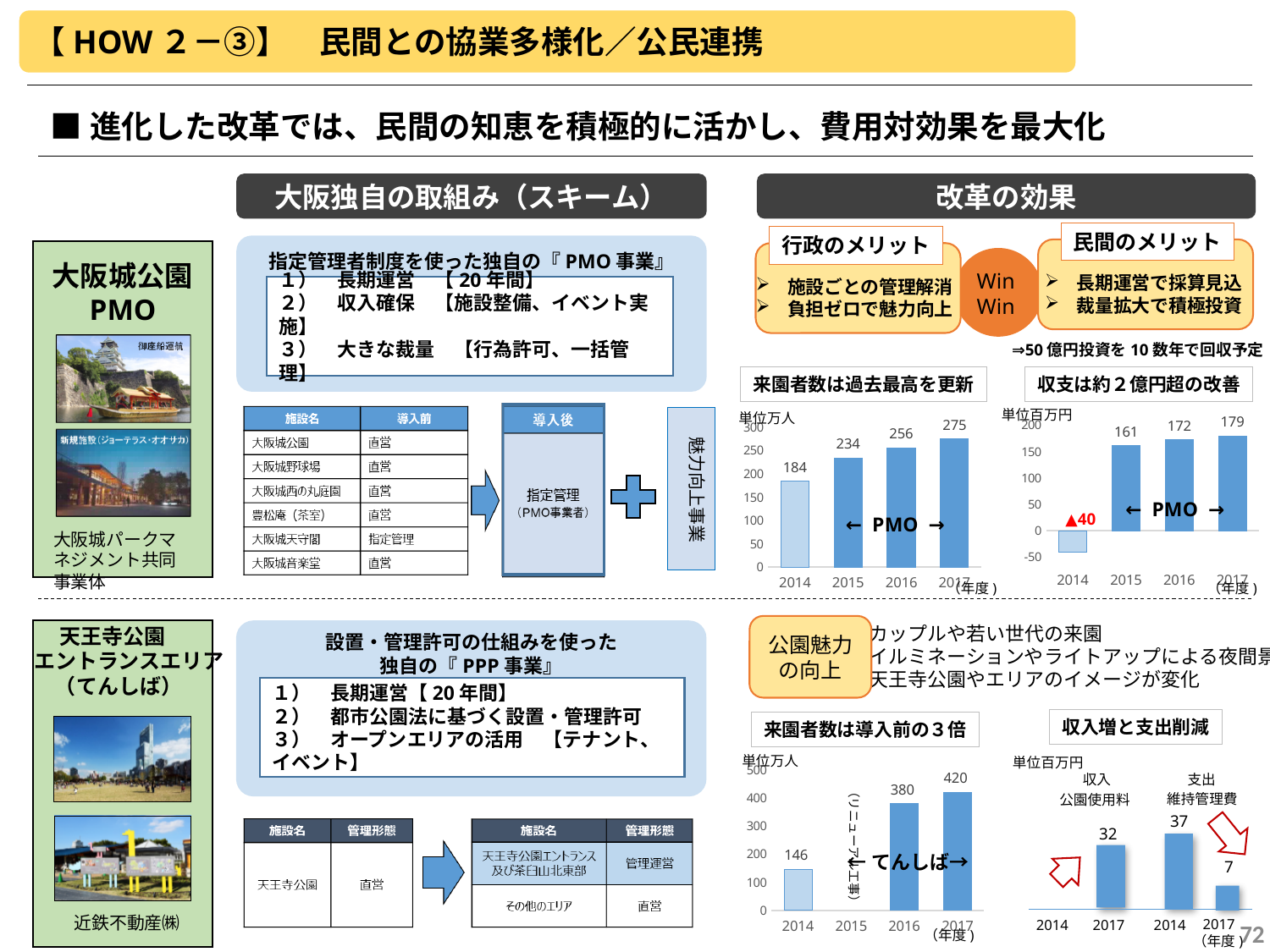
In the chart titled 収支は約２億円超の改善, which year has the highest value? 2017 In the chart titled 収入増と支出削減, what is the 支出 (維持管理費) value for 2017? 7 In the chart titled 収入増と支出削減, what is the difference between the 支出 values for 2014 and 2017? 30 In the chart titled 収支は約２億円超の改善, what is the value for 2014? ▲40 What kind of chart is the one titled 来園者数は過去最高を更新? bar chart In the chart titled 来園者数は過去最高を更新, what is the value for 2014? 184 In the chart titled 来園者数は過去最高を更新, what is the difference between the 2017 and 2014 values? 91 In the chart titled 来園者数は導入前の３倍, which year has the lowest value? 2014 In the chart titled 来園者数は過去最高を更新, do the values rise or fall from 2014 to 2017? rise In the chart titled 来園者数は過去最高を更新, what is the value for 2017? 275 In the chart titled 来園者数は導入前の３倍, what is the value for 2016? 380 In the chart titled 収支は約２億円超の改善, what is the difference between the 2016 and 2015 values? 11